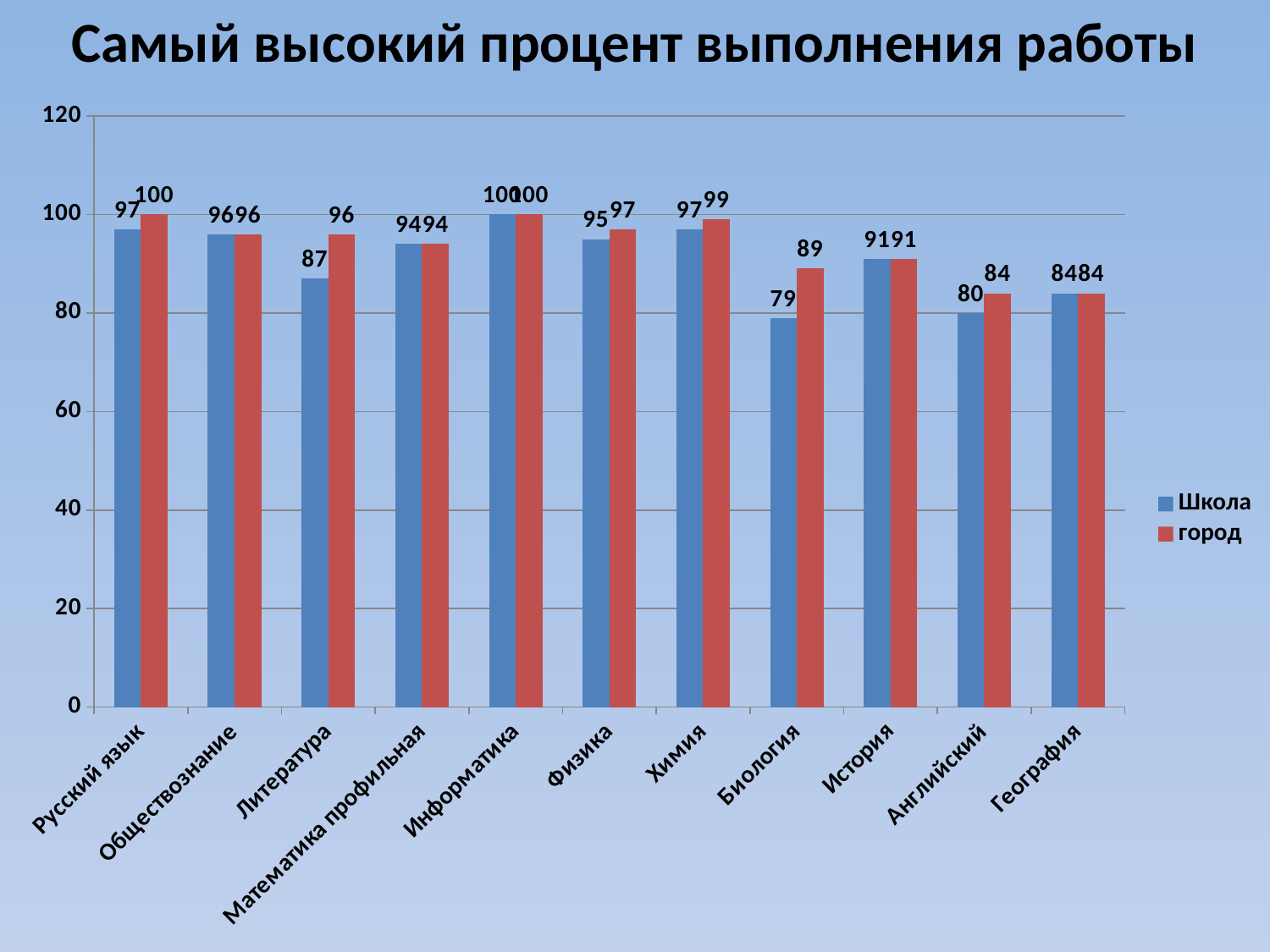
Which is larger for Русский язык, the Школа value or the город value? город What is the difference between the город and Школа values for Литература? 9 How many series does the legend list? 2 How many categories are shown on the x axis? 11 What is the title of the chart? Самый высокий процент выполнения работы What is the value for Школа in Литература? 87 What is the value for город in Биология? 89 Which category has the highest value for Школа? Информатика Which category has the lowest value for Школа? Биология What is the value for Школа in Английский? 80 What kind of chart is shown on the slide? bar chart What is the difference between the город and Школа values for Биология? 10